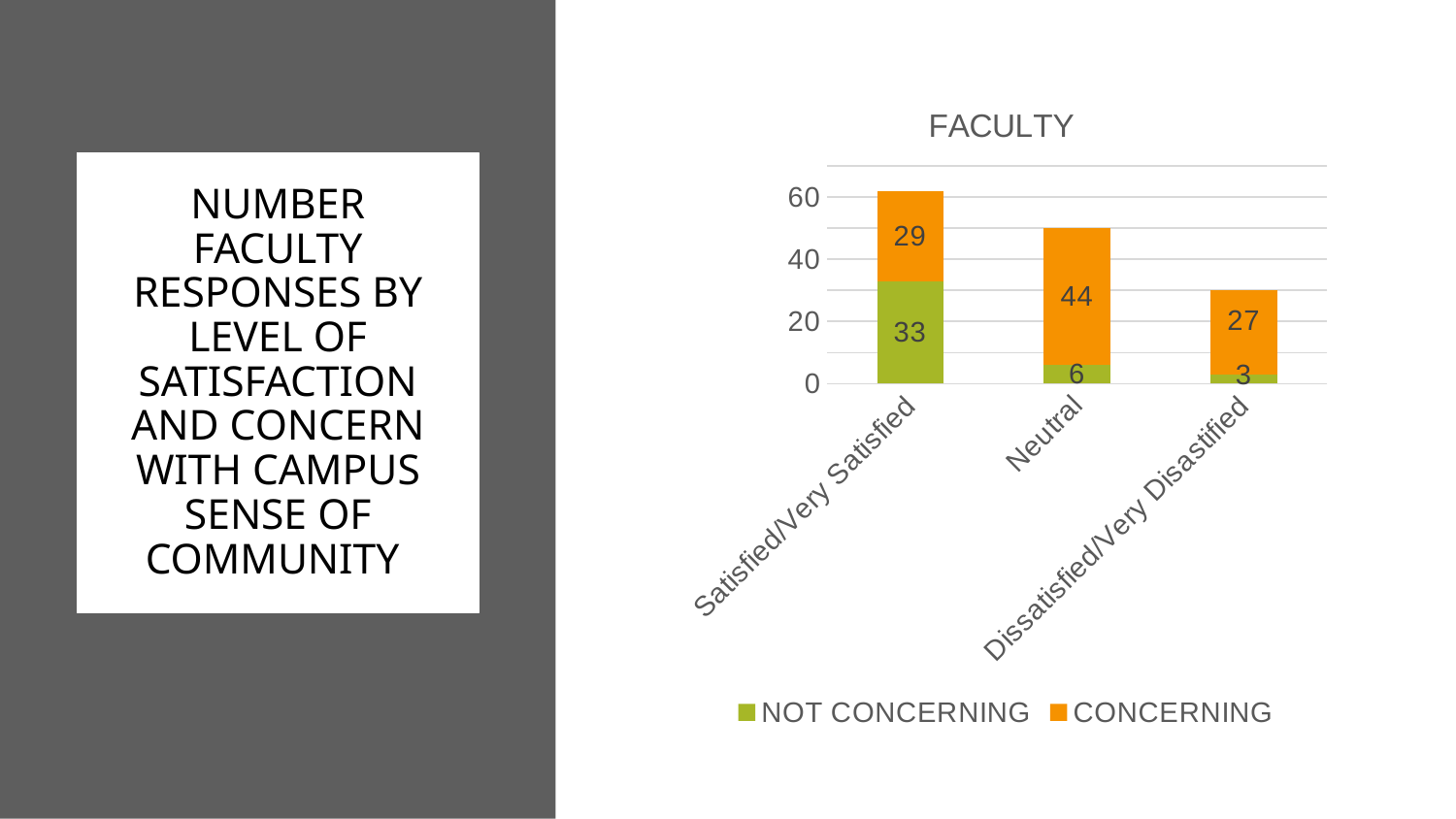
Which category has the lowest NOT CONCERNING value? Dissatisfied/Very Disastified Which is larger: the NOT CONCERNING value for Satisfied/Very Satisfied or the CONCERNING value for Satisfied/Very Satisfied? NOT CONCERNING What is the CONCERNING value for Neutral? 44 How many series does the legend list? 2 Which category has the highest CONCERNING value? Neutral What is the CONCERNING value for Dissatisfied/Very Disastified? 27 What is the NOT CONCERNING value for Satisfied/Very Satisfied? 33 What kind of chart is shown? Stacked bar chart What is the total of the stacked bar for Neutral? 50 What is the total of the stacked bar for Satisfied/Very Satisfied? 62 What is the NOT CONCERNING value for Neutral? 6 What is the difference between the CONCERNING value for Neutral and the CONCERNING value for Satisfied/Very Satisfied? 15